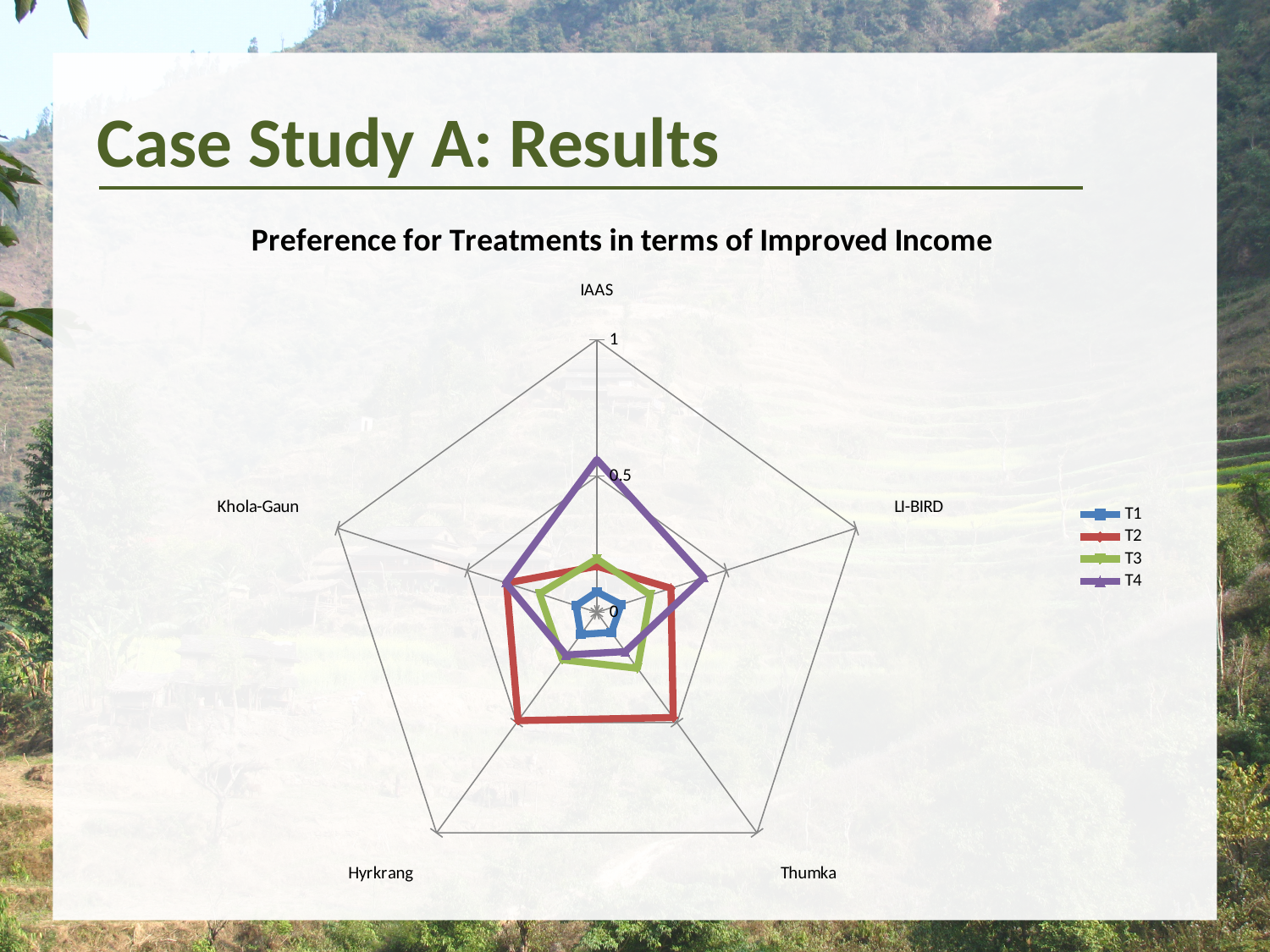
Which series has the highest value for Hyrkrang? T2 How many categories (axes) does the radar chart have? 5 Which series has the highest value for Thumka? T2 What kind of chart is shown on the slide? Radar chart How many series does the legend list? 4 Which series are listed in the legend? T1, T2, T3, T4 Which series has the highest value for IAAS? T4 Is the value for T1 at IAAS greater or less than 0.5? less What is the title of the chart? Preference for Treatments in terms of Improved Income For LI-BIRD, which is larger: the value for T4 or the value for T2? T4 Is the value for T4 at Khola-Gaun greater or less than 0.5? less Which series has the lowest value for IAAS? T1